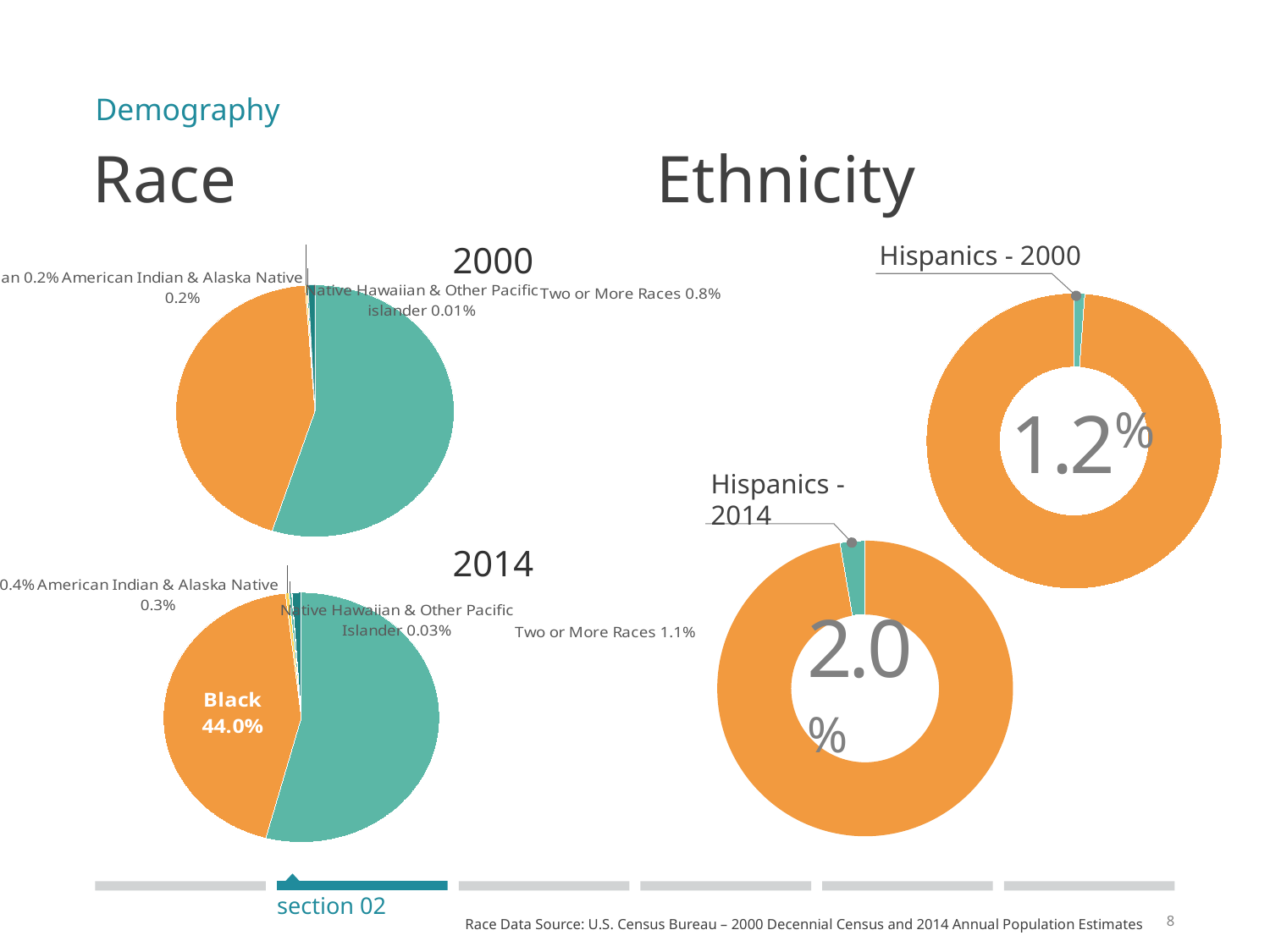
In the Race 2000 pie chart, what percentage is shown for Native Hawaiian & Other Pacific Islander? 0.01% In the Hispanics - 2000 chart, what percentage is shown in the centre? 1.2% In the Race 2014 pie chart, what percentage is shown for Native Hawaiian & Other Pacific Islander? 0.03% Which is larger, the Hispanic share in 2000 or in 2014? 2014 In the Race 2000 pie chart, what percentage is shown for American Indian & Alaska Native? 0.2% In the Race 2014 pie chart, what percentage is shown for Black? 44.0% In the Race 2014 pie chart, what percentage is shown for Two or More Races? 1.1% In the Race 2000 pie chart, what percentage is shown for Two or More Races? 0.8% What is the difference between the Two or More Races value in the Race 2014 pie chart and in the Race 2000 pie chart? 0.3% What kind of chart is used for the Race 2000 data? Pie chart By how many percentage points did the Hispanic share change from the Hispanics - 2000 chart to the Hispanics - 2014 chart? 0.8% In the Hispanics - 2014 chart, what percentage is shown in the centre? 2.0%